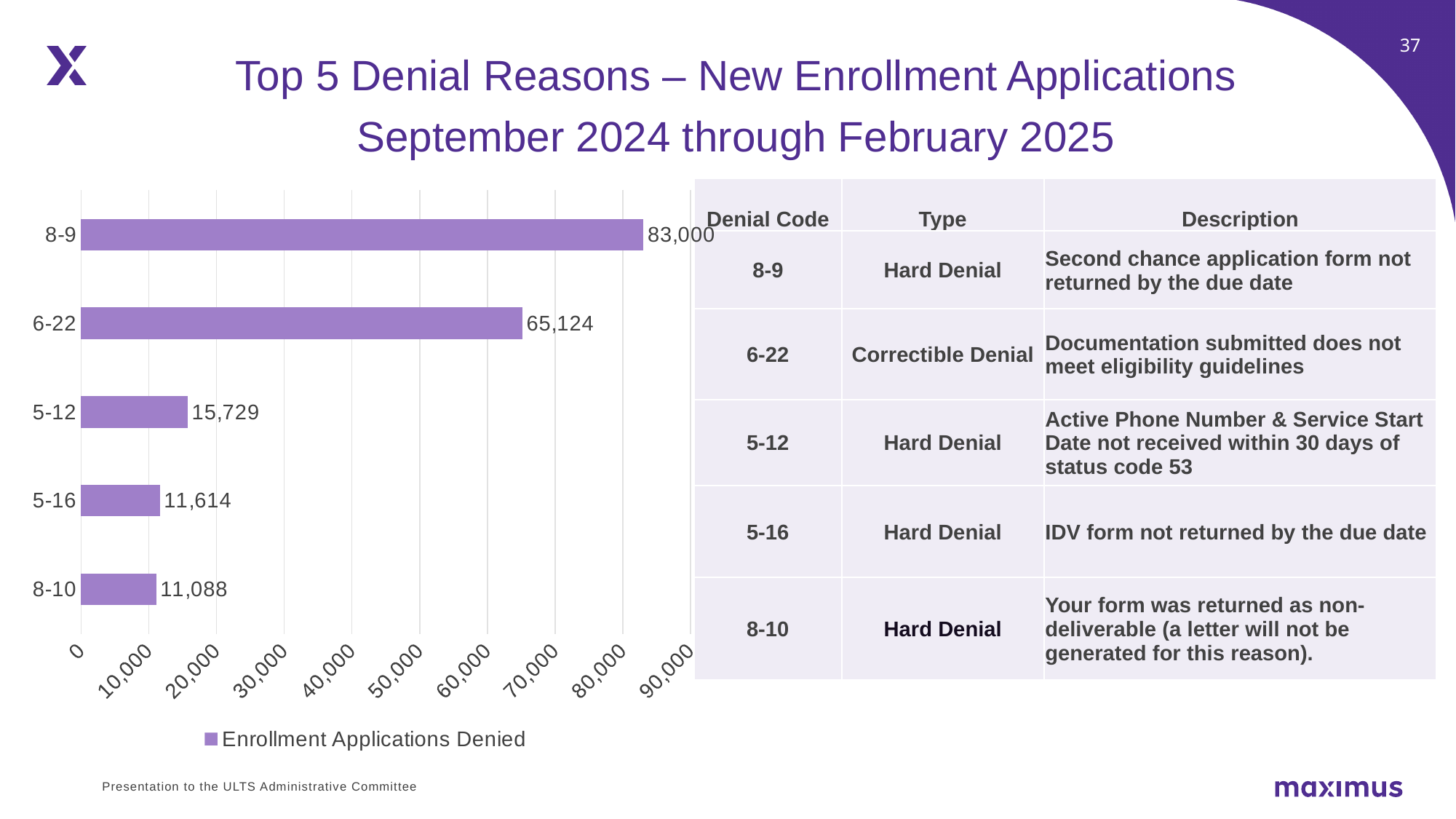
Which denial code has the highest number of enrollment applications denied? 8-9 Which denial code has the lowest number of enrollment applications denied? 8-10 What is the number of enrollment applications denied for denial code 5-12? 15,729 What kind of chart is used to show the enrollment applications denied? Bar chart What is the number of enrollment applications denied for denial code 8-9? 83,000 Is the value for 6-22 greater or less than 60,000? greater What is the number of enrollment applications denied for denial code 8-10? 11,088 How many denial codes are shown in the bar chart? 5 What series name does the chart legend show? Enrollment Applications Denied What is the number of enrollment applications denied for denial code 6-22? 65,124 What is the difference between the enrollment applications denied for 8-9 and 6-22? 17,876 Which has more enrollment applications denied, 5-16 or 8-10? 5-16